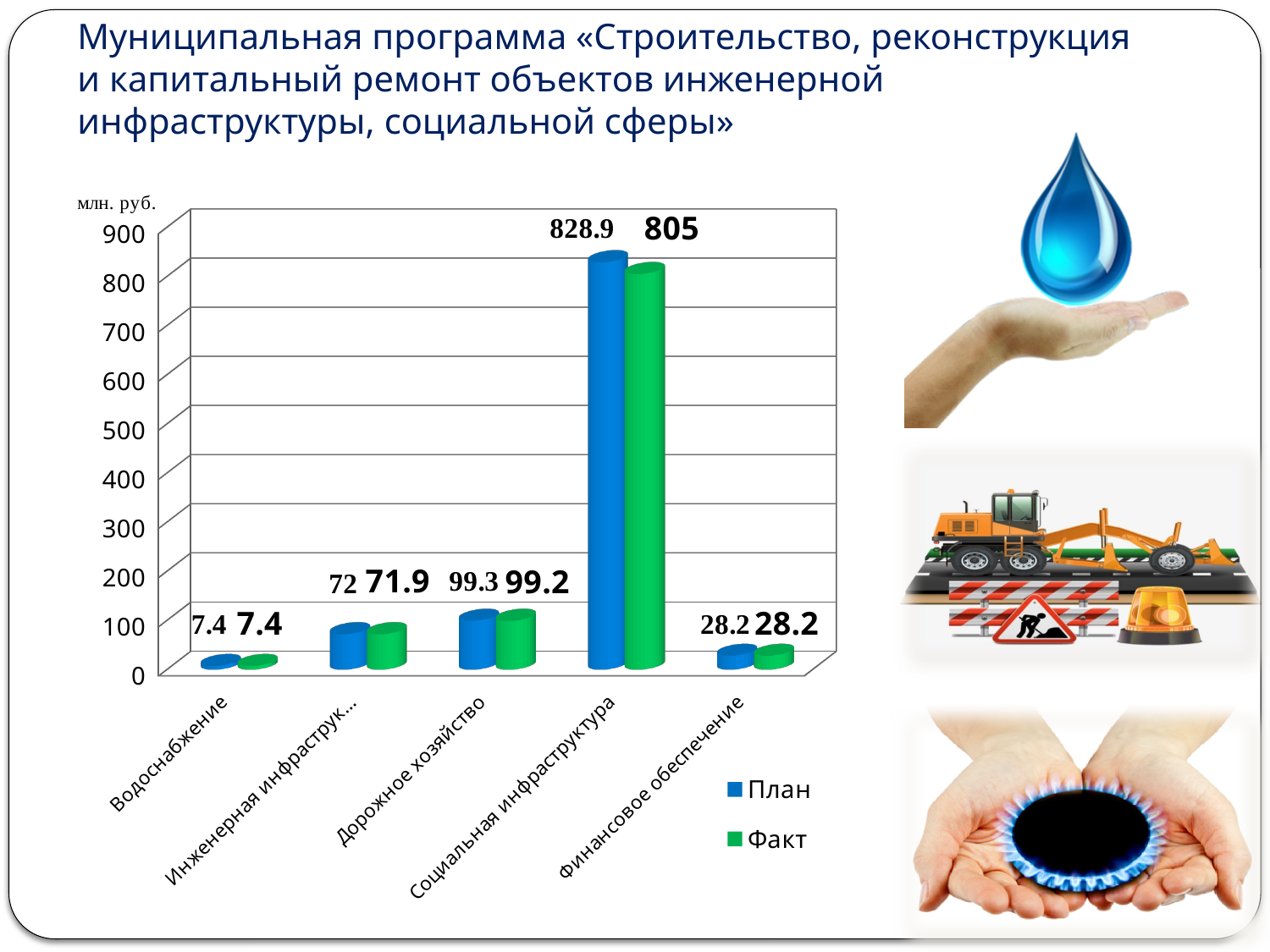
What unit is shown above the vertical axis? млн. руб. Which is larger for Дорожное хозяйство: the План value or the Факт value? План What is the difference between the План and Факт values for Социальная инфраструктура? 23.9 What is the Факт value for Дорожное хозяйство? 99.2 Is the Факт value for Социальная инфраструктура greater or less than 700? greater How many series does the legend list? 2 How many categories are shown on the x axis? 5 Which category has the highest План value? Социальная инфраструктура What is the План value for Финансовое обеспечение? 28.2 What is the План value for Социальная инфраструктура? 828.9 Which category has the lowest Факт value? Водоснабжение What is the Факт value for Социальная инфраструктура? 805